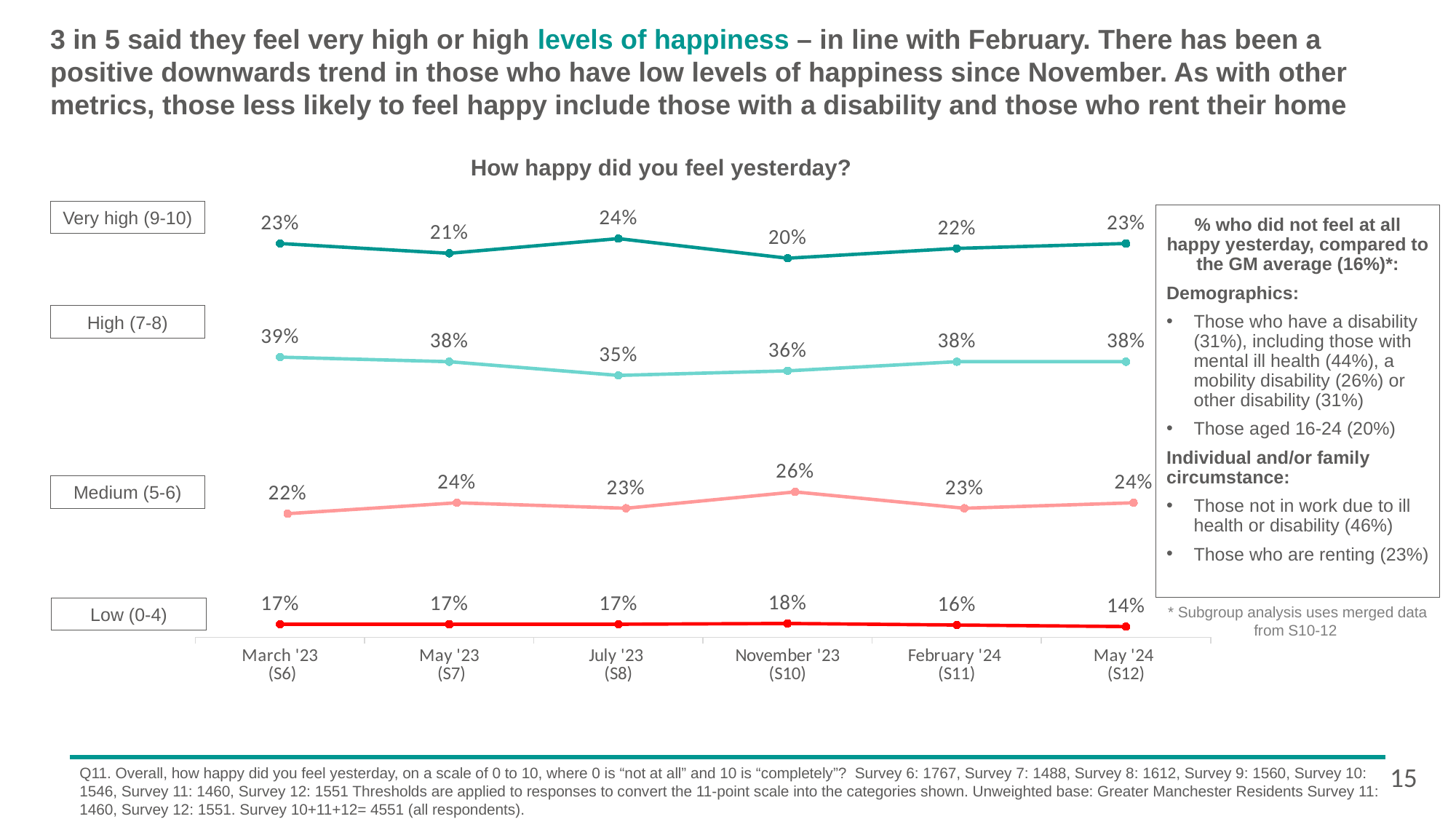
What kind of chart is shown on the slide? Line chart How many survey waves are plotted along the x axis? 6 Does the Low (0-4) series rise or fall from November '23 (S10) to May '24 (S12)? Fall What is the difference between the High (7-8) value in March '23 (S6) and in July '23 (S8)? 4 percentage points In November '23 (S10), which is larger: the Medium (5-6) value or the Very high (9-10) value? Medium (5-6) In which survey wave is the Low (0-4) value lowest? May '24 (S12) What is the title of the chart? How happy did you feel yesterday? What is the value for High (7-8) in July '23 (S8)? 35% In which survey wave is the Very high (9-10) value highest? July '23 (S8) What is the value for Low (0-4) in May '24 (S12)? 14% What is the value for Medium (5-6) in November '23 (S10)? 26% How many series (happiness categories) are plotted on the chart? 4